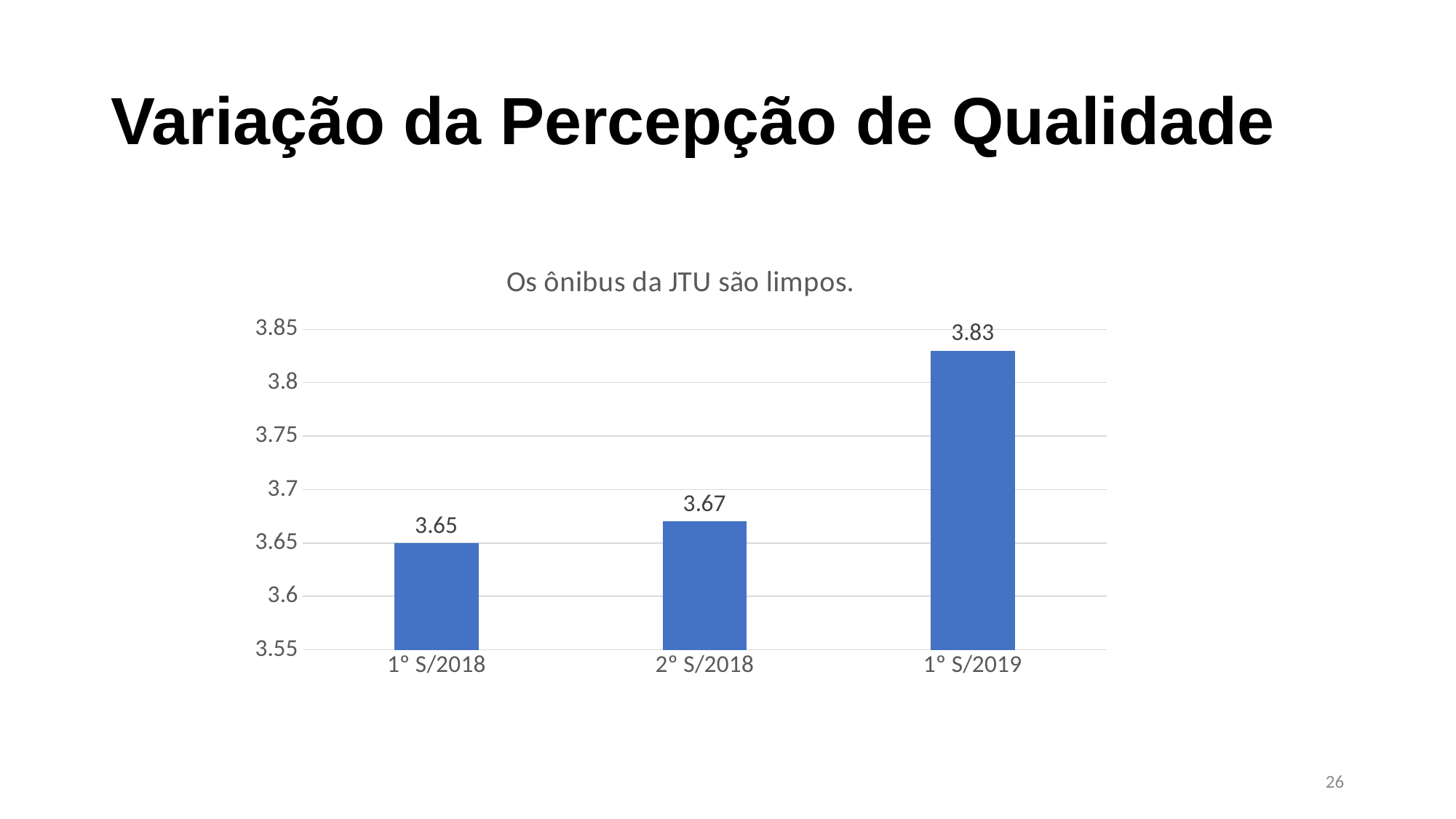
What is the value for 2° S/2018? 3.67 Which is larger, the value for 1° S/2019 or the value for 2° S/2018? 1° S/2019 Do the values rise or fall from 1° S/2018 to 1° S/2019? rise How many periods are shown on the x axis? 3 What is the value for 1° S/2018? 3.65 What is the difference between the values for 1° S/2019 and 1° S/2018? 0.18 Is the value for 1° S/2019 greater or less than 3.8? greater What is the value for 1° S/2019? 3.83 What kind of chart is shown on the slide? bar chart Which period has the highest value? 1° S/2019 Which period has the lowest value? 1° S/2018 What is the difference between the values for 2° S/2018 and 1° S/2018? 0.02